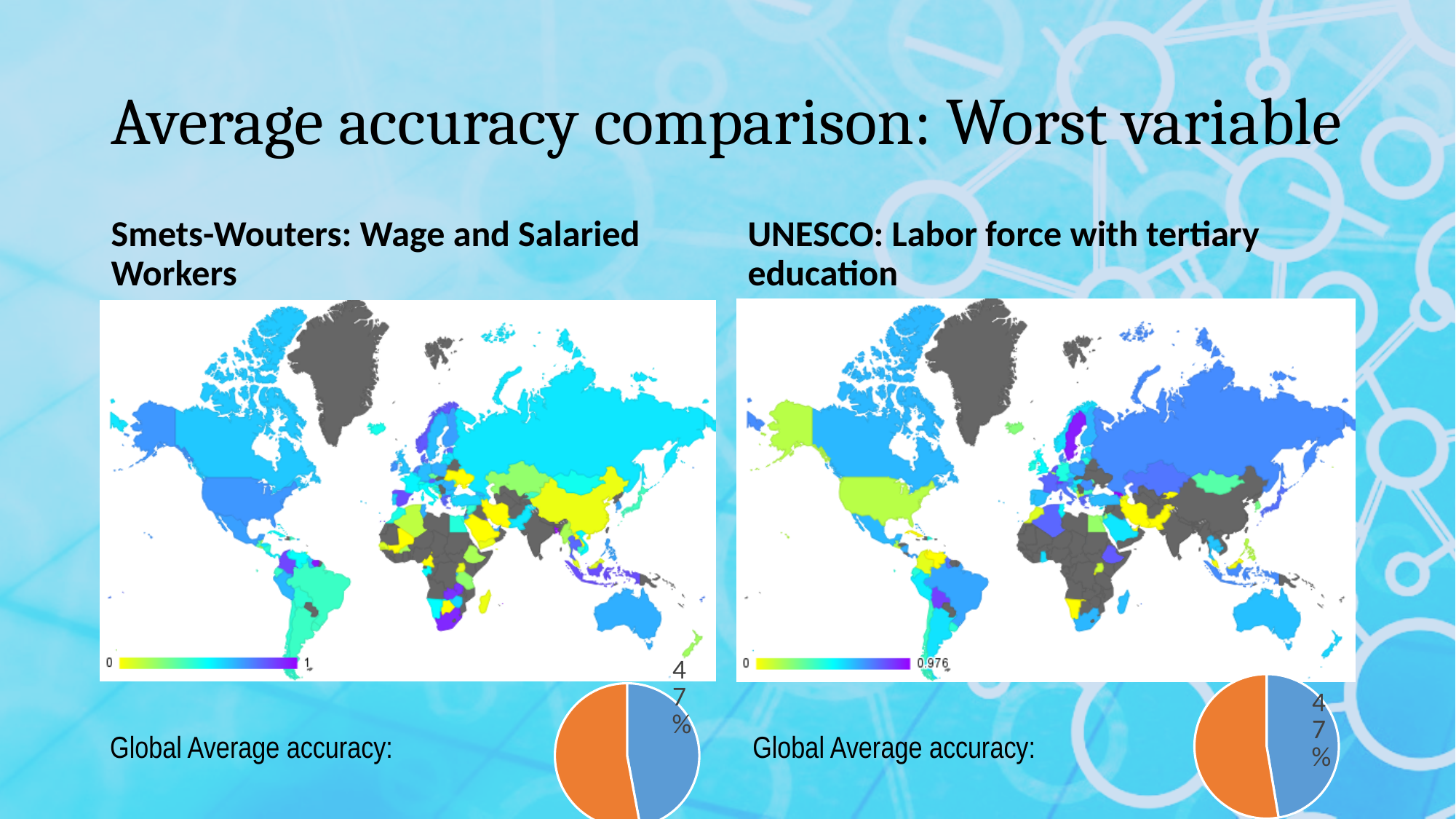
What is the title of the map on the right side of the slide? UNESCO: Labor force with tertiary education How many slices does the pie chart under the UNESCO map have? 2 What kind of chart is shown at the bottom left of the slide, next to 'Global Average accuracy:' under the Smets-Wouters map? pie chart What is the title of the map on the left side of the slide? Smets-Wouters: Wage and Salaried Workers In the pie chart under the Smets-Wouters map, what percentage is printed on the blue slice? 47% What kind of chart is shown at the bottom right of the slide, next to 'Global Average accuracy:' under the UNESCO map? pie chart What is the maximum value shown on the colour scale of the Smets-Wouters: Wage and Salaried Workers map? 1 In the pie chart under the UNESCO map, which slice is larger, the orange one or the blue one? orange In the pie chart under the Smets-Wouters map, is the blue slice's share greater or less than 50%? less How many slices does the pie chart under the Smets-Wouters map have? 2 In the pie chart under the UNESCO map, what percentage is printed on the blue slice? 47%